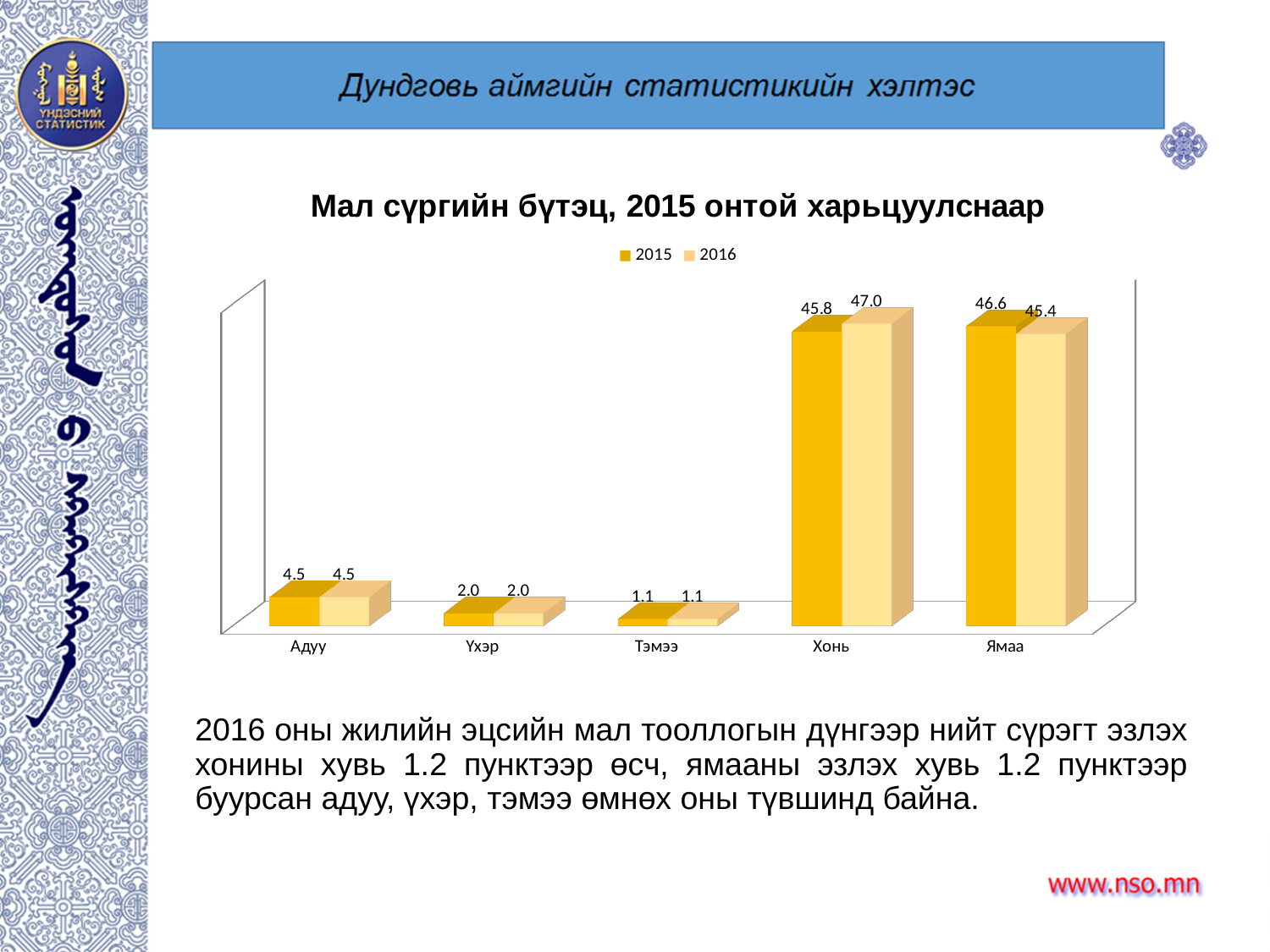
How many categories are shown on the x axis? 5 What is the value for Адуу in 2016? 4.5 What is the value for Ямаа in 2015? 46.6 How many series does the legend list? 2 Which category has the lowest value in the 2015 series? Тэмээ Which is larger for Ямаа: the 2015 value or the 2016 value? 2015 What is the value for Тэмээ in 2015? 1.1 What is the difference between the 2015 and 2016 values for Ямаа? 1.2 What is the difference between the 2016 and 2015 values for Хонь? 1.2 Which category has the highest value in the 2016 series? Хонь What is the value for Хонь in 2016? 47.0 What kind of chart is shown on the slide? Bar chart